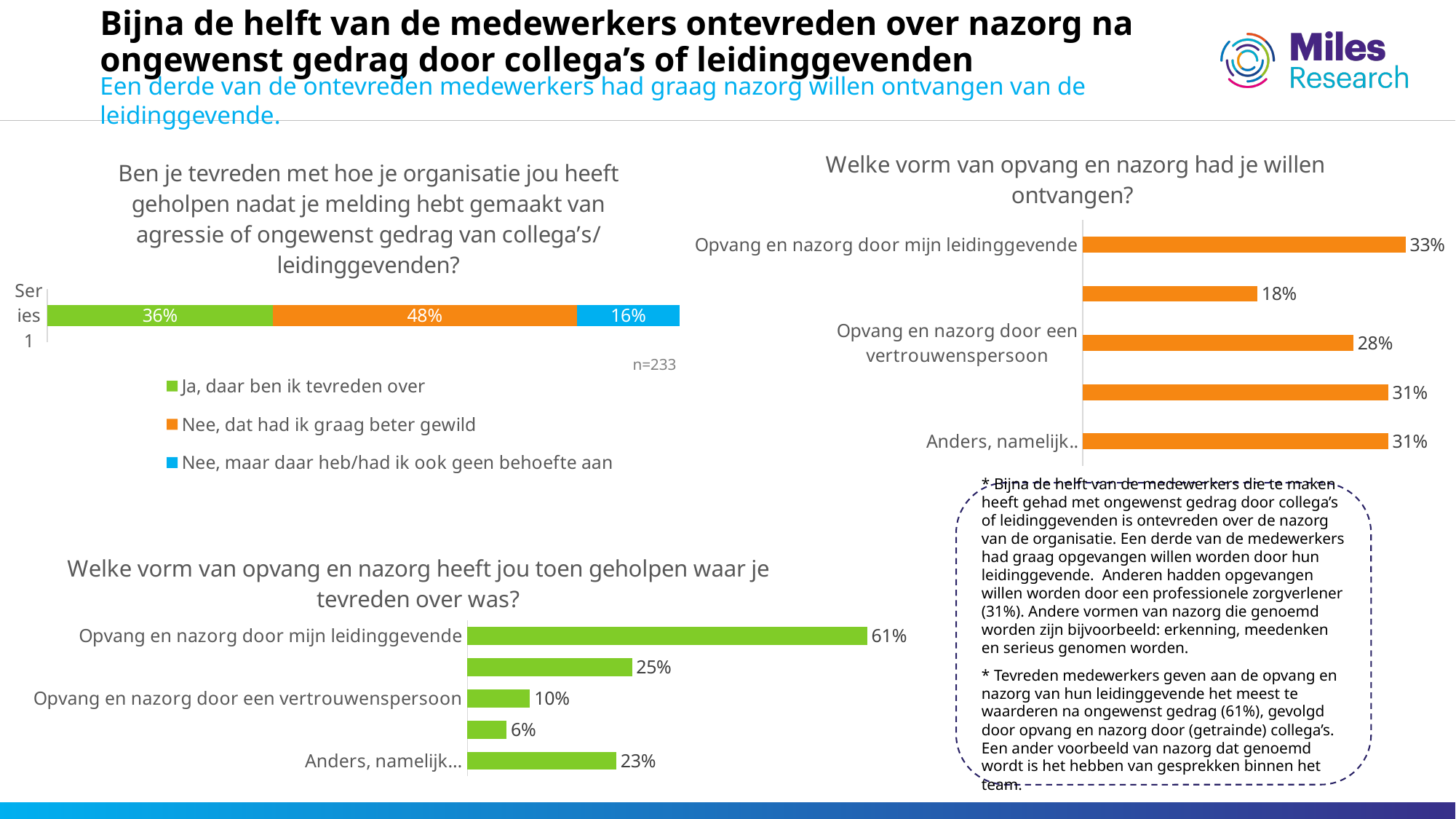
In the chart 'Ben je tevreden met hoe je organisatie jou heeft geholpen...', what percentage answered 'Ja, daar ben ik tevreden over'? 36% In the chart 'Welke vorm van opvang en nazorg had je willen ontvangen?', what is the value for 'Opvang en nazorg door mijn leidinggevende'? 33% In the chart 'Welke vorm van opvang en nazorg heeft jou toen geholpen waar je tevreden over was?', which category has the highest value? Opvang en nazorg door mijn leidinggevende In the chart 'Ben je tevreden met hoe je organisatie jou heeft geholpen...', what is the difference between 'Nee, dat had ik graag beter gewild' and 'Nee, maar daar heb/had ik ook geen behoefte aan'? 32% In the chart 'Ben je tevreden met hoe je organisatie jou heeft geholpen...', how many entries does the legend list? 3 What type of chart is 'Welke vorm van opvang en nazorg heeft jou toen geholpen waar je tevreden over was?'? Bar chart In the chart 'Welke vorm van opvang en nazorg had je willen ontvangen?', how many bars are plotted? 5 In the chart 'Ben je tevreden met hoe je organisatie jou heeft geholpen...', what percentage answered 'Nee, dat had ik graag beter gewild'? 48% In the chart 'Ben je tevreden met hoe je organisatie jou heeft geholpen...', which answer option has the largest share? Nee, dat had ik graag beter gewild In the chart 'Welke vorm van opvang en nazorg heeft jou toen geholpen waar je tevreden over was?', what is the value for 'Opvang en nazorg door mijn leidinggevende'? 61% In the chart 'Welke vorm van opvang en nazorg heeft jou toen geholpen waar je tevreden over was?', which is larger: 'Opvang en nazorg door een vertrouwenspersoon' or 'Anders, namelijk...'? Anders, namelijk... In the chart 'Welke vorm van opvang en nazorg had je willen ontvangen?', what is the value for 'Opvang en nazorg door een vertrouwenspersoon'? 28%